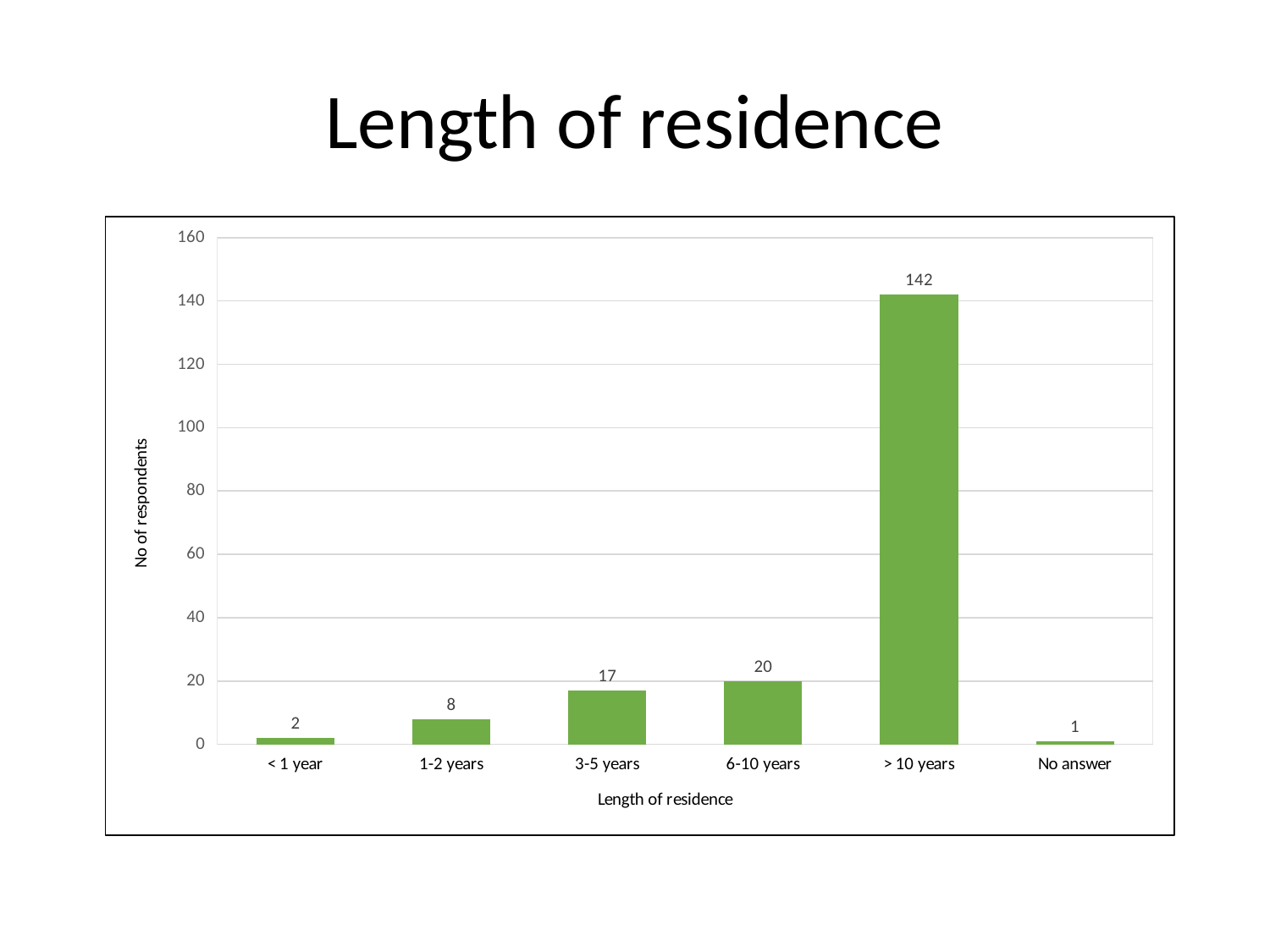
Is the value for > 10 years greater or less than 140? greater Which category has the lowest number of respondents? No answer What is the difference in respondents between the > 10 years and 6-10 years categories? 122 What is the difference in respondents between the 6-10 years and 3-5 years categories? 3 What type of chart is shown on the slide? Bar chart How many length of residence categories are shown on the x axis? 6 What is the label of the vertical axis? No of respondents How many respondents reported a length of residence of more than 10 years? 142 What is the number of respondents for the 3-5 years category? 17 Which length of residence category has the highest number of respondents? > 10 years Which has more respondents, 1-2 years or < 1 year? 1-2 years What is the number of respondents for the 1-2 years category? 8